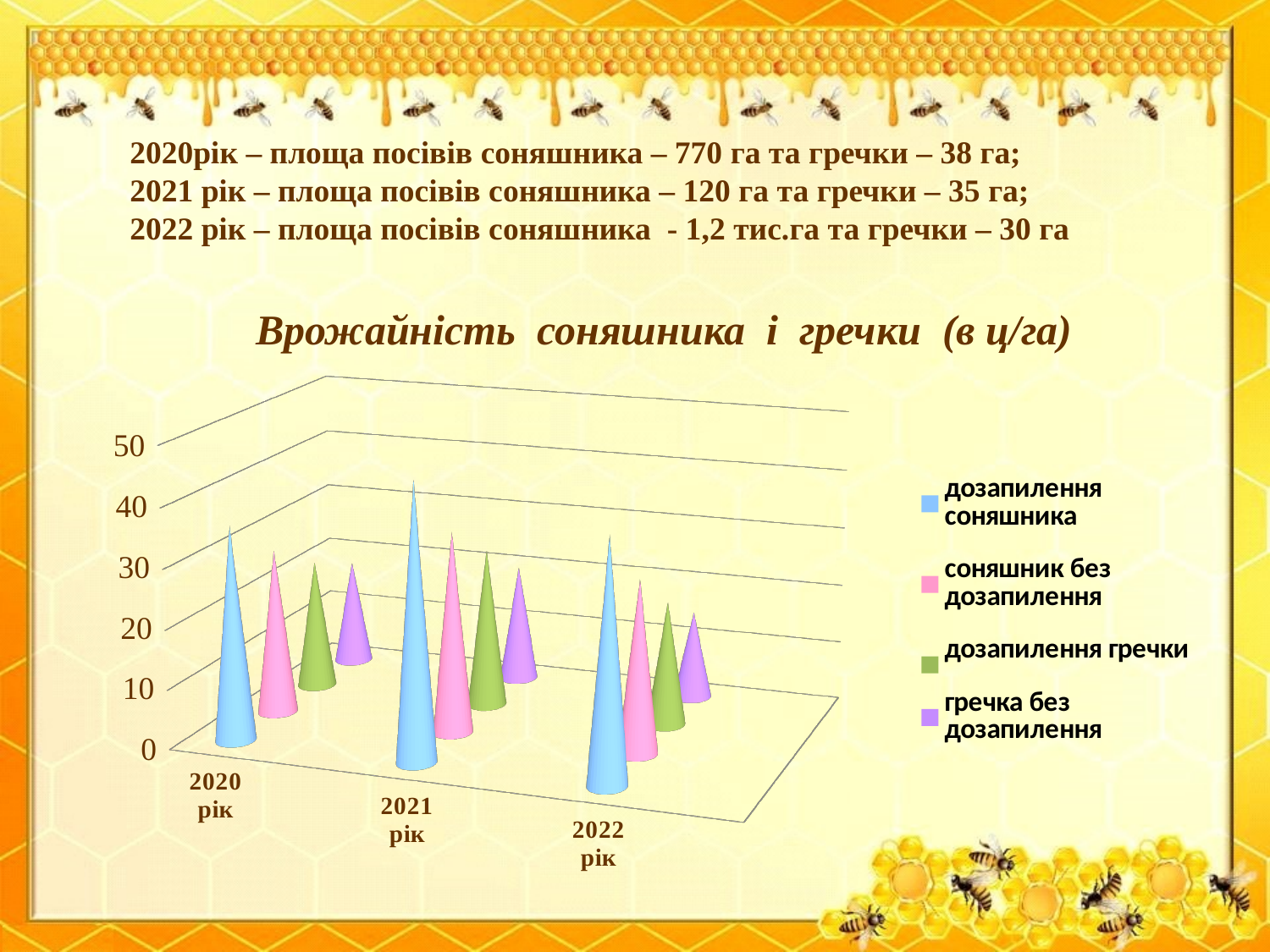
How many year categories are shown on the x axis of the chart? 3 In which year is the value for 'дозапилення соняшника' the highest? 2021 рік What is the title of the chart? Врожайність соняшника і гречки (в ц/га) Which colour represents the series 'дозапилення соняшника' in the chart? blue What kind of chart is shown on the slide? bar chart Which series has the highest value in 2021 рік? дозапилення соняшника Is the value for 'дозапилення соняшника' in 2021 рік greater or less than 30? greater Is the value for 'гречка без дозапилення' in 2022 рік greater or less than 40? less Is the value for 'дозапилення соняшника' in 2020 рік greater or less than 20? greater How many series does the chart legend list? 4 In 2022 рік, which is larger: 'соняшник без дозапилення' or 'дозапилення гречки'? соняшник без дозапилення In 2020 рік, which is larger: 'дозапилення соняшника' or 'соняшник без дозапилення'? дозапилення соняшника